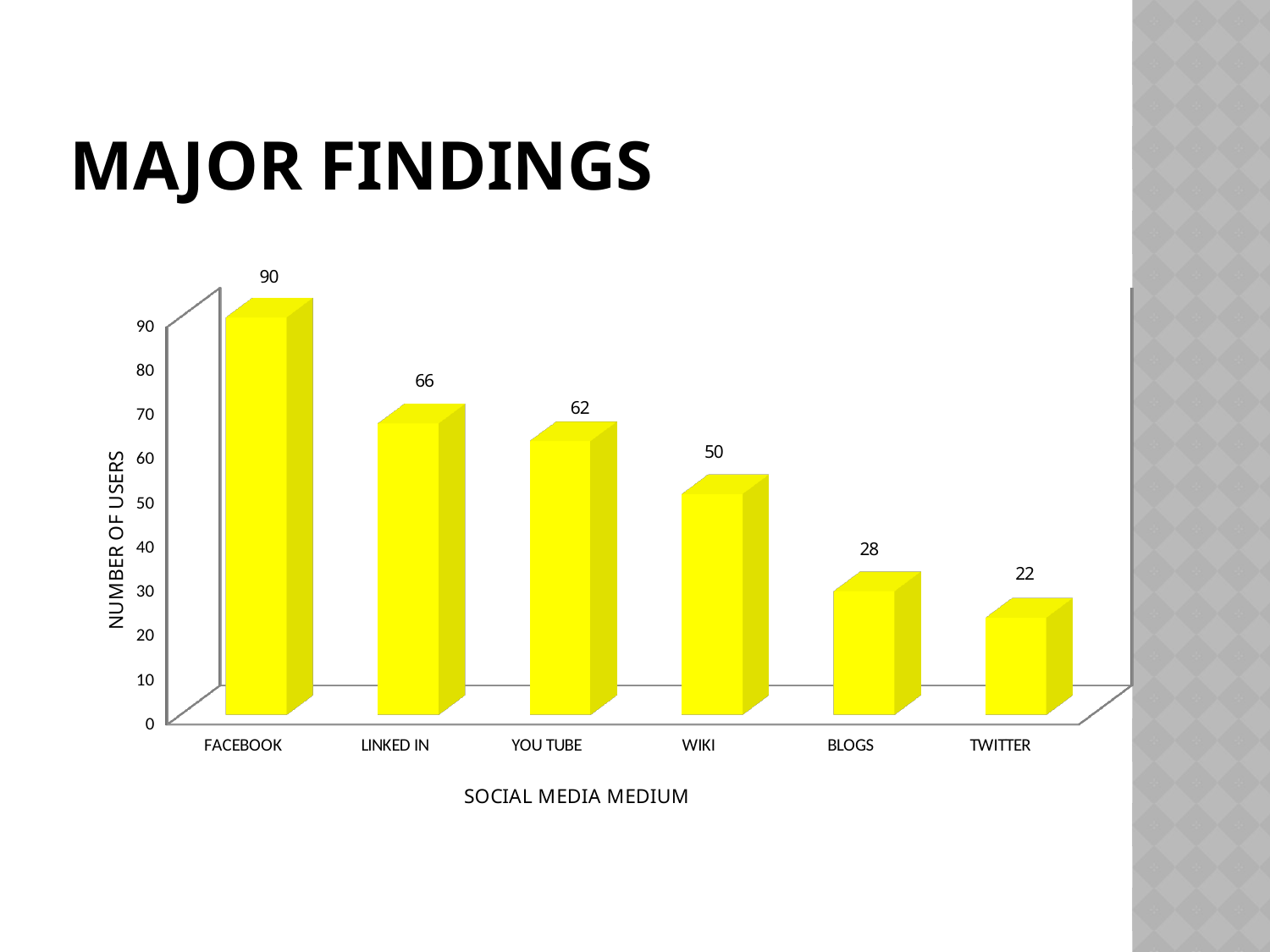
Which social media medium has the lowest number of users? TWITTER What is the number of users for WIKI? 50 What is the number of users for TWITTER? 22 What is the number of users for FACEBOOK? 90 Which social media medium has the highest number of users? FACEBOOK What is the label of the y axis? NUMBER OF USERS What kind of chart is shown on the slide? Bar chart Which has more users, WIKI or BLOGS? WIKI How many social media mediums are shown on the x axis? 6 What is the difference in number of users between LINKED IN and YOU TUBE? 4 What is the difference in number of users between FACEBOOK and BLOGS? 62 Do the values rise or fall moving from FACEBOOK to TWITTER along the x axis? Fall